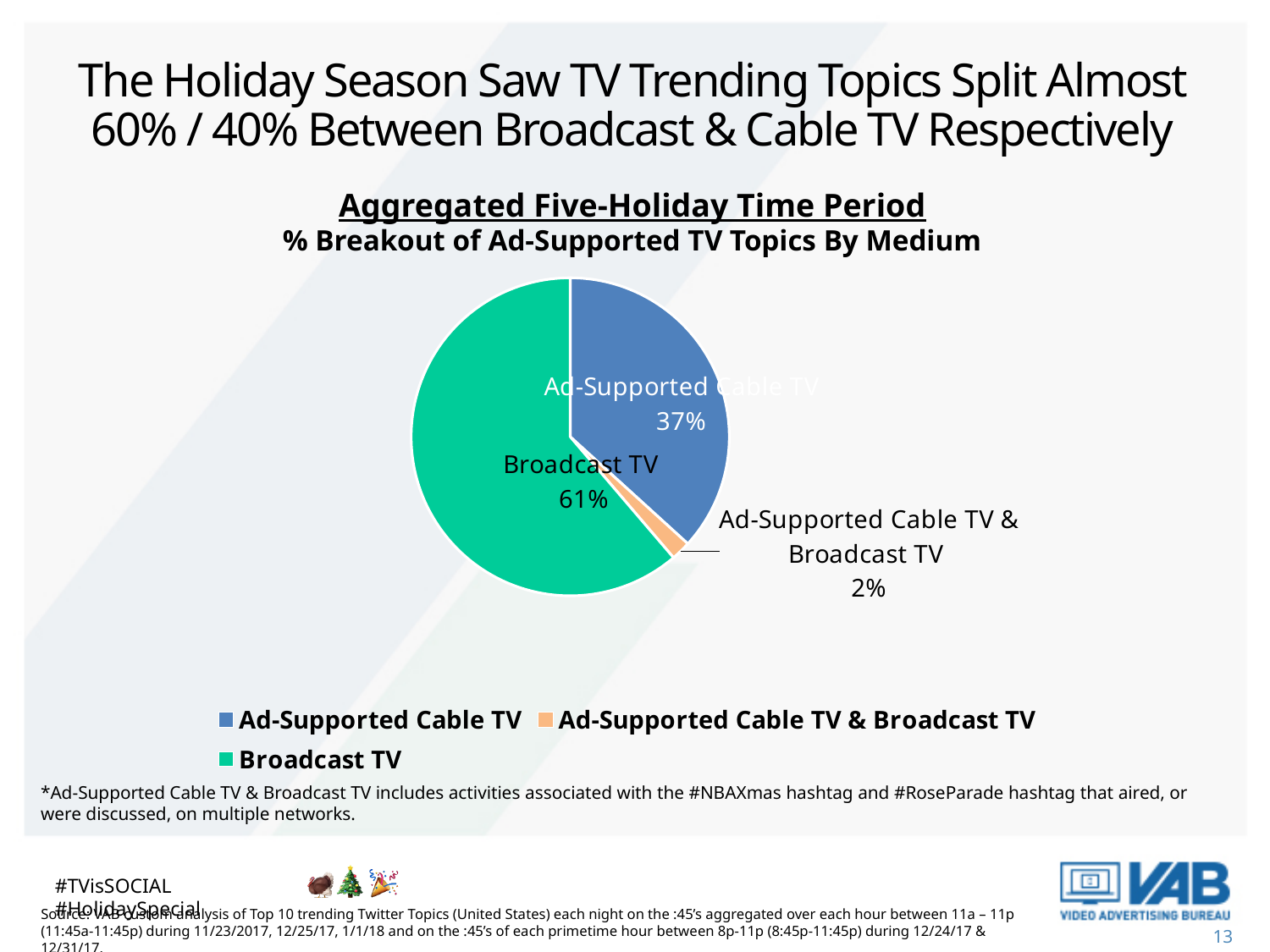
Which medium has the largest share of the pie? Broadcast TV What is the difference in percentage points between Broadcast TV and Ad-Supported Cable TV? 24 What percentage is shown for the Ad-Supported Cable TV & Broadcast TV slice? 2% How many slices does the pie chart have? 3 Which medium has the smallest share of the pie? Ad-Supported Cable TV & Broadcast TV How many entries does the legend list? 3 Which is larger, the share for Ad-Supported Cable TV or the share for Broadcast TV? Broadcast TV What is the subtitle of the chart below 'Aggregated Five-Holiday Time Period'? % Breakout of Ad-Supported TV Topics By Medium What kind of chart is shown on the slide? pie chart What colour is the Broadcast TV slice? green What percentage of ad-supported TV topics is attributed to Broadcast TV? 61% What percentage of ad-supported TV topics is attributed to Ad-Supported Cable TV? 37%